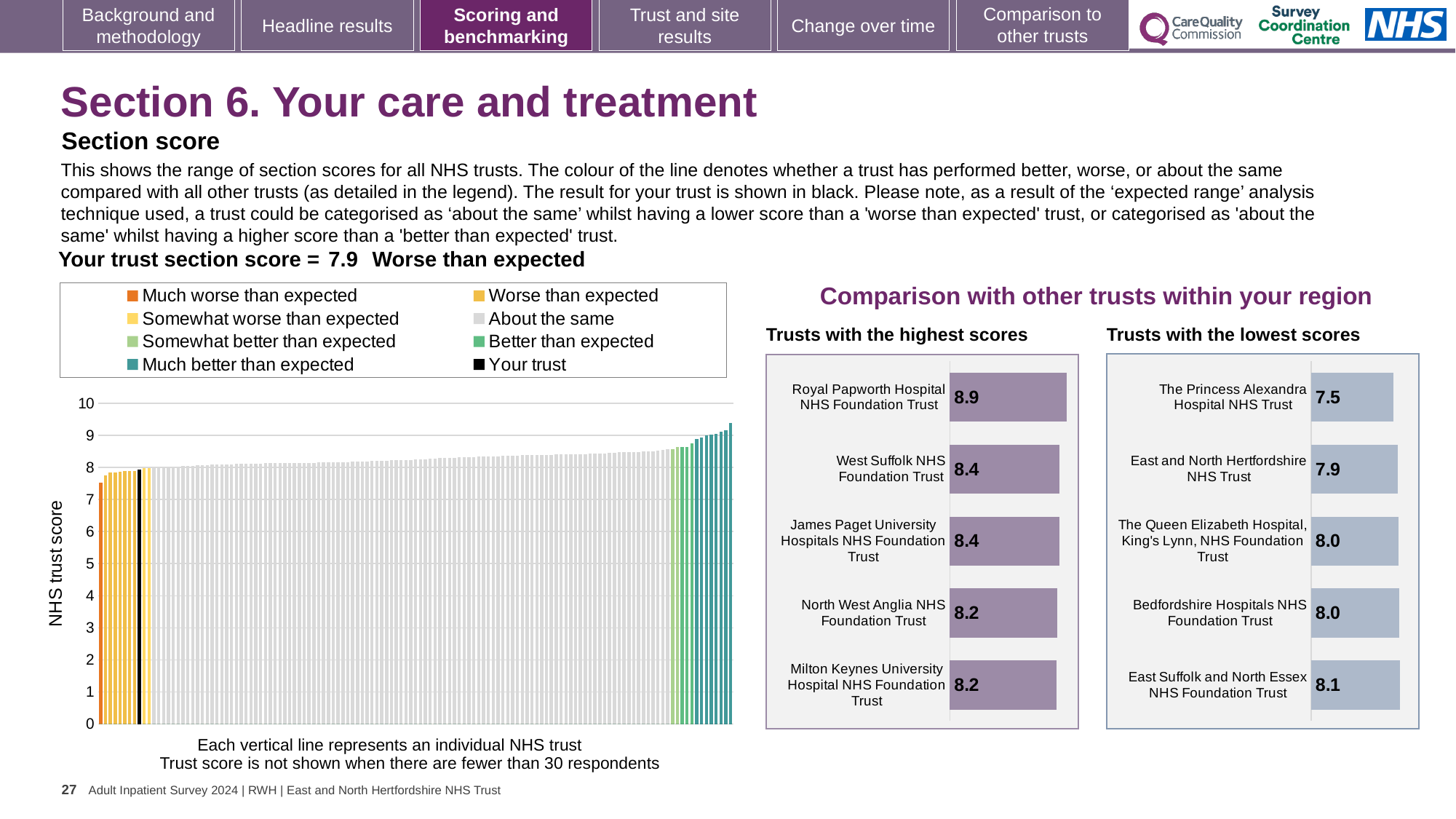
In the 'Trusts with the lowest scores' chart, what is the score for The Princess Alexandra Hospital NHS Trust? 7.5 In the 'Trusts with the lowest scores' chart, which has the larger score: The Princess Alexandra Hospital NHS Trust or East and North Hertfordshire NHS Trust? East and North Hertfordshire NHS Trust In the 'Trusts with the lowest scores' chart, which trust has the lowest score? The Princess Alexandra Hospital NHS Trust In the 'Trusts with the lowest scores' chart, what is the score for East Suffolk and North Essex NHS Foundation Trust? 8.1 In the 'Trusts with the highest scores' chart, what is the score for Royal Papworth Hospital NHS Foundation Trust? 8.9 In the 'Trusts with the highest scores' chart, what is the difference between the scores of Royal Papworth Hospital NHS Foundation Trust and Milton Keynes University Hospital NHS Foundation Trust? 0.7 What is the section score for your trust shown on the slide? 7.9 In the main chart of NHS trust scores on the left, do the bar values rise or fall from left to right? rise How many trusts are shown in the 'Trusts with the highest scores' chart? 5 In the 'Trusts with the highest scores' chart, which trust has the highest score? Royal Papworth Hospital NHS Foundation Trust In the main chart of NHS trust scores on the left, is the value of the tallest bar greater or less than 9? greater How many entries does the legend of the main chart on the left list? 8